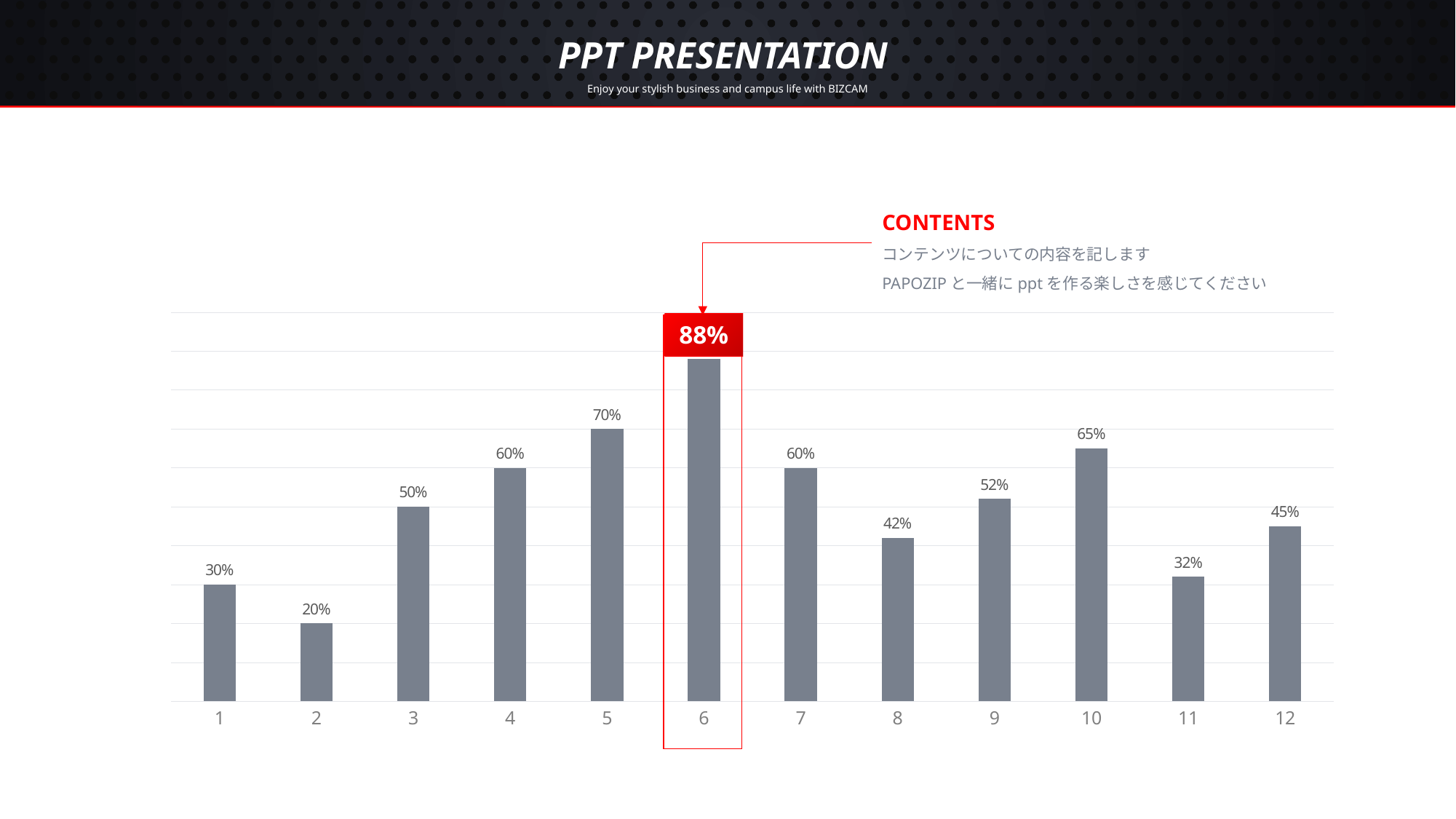
What is the value for category 6? 88% What is the value for category 10? 65% What kind of chart is shown on the slide? Bar chart Which category has the lowest value? 2 How many categories are shown on the x axis? 12 Which is larger, the value for category 11 or the value for category 12? 12 Which category has the highest value? 6 What is the value for category 2? 20% Do the values rise or fall from category 1 to category 6? Rise Which is larger, the value for category 3 or the value for category 7? 7 What is the difference between the values for category 6 and category 5? 18% What is the difference between the values for category 9 and category 8? 10%